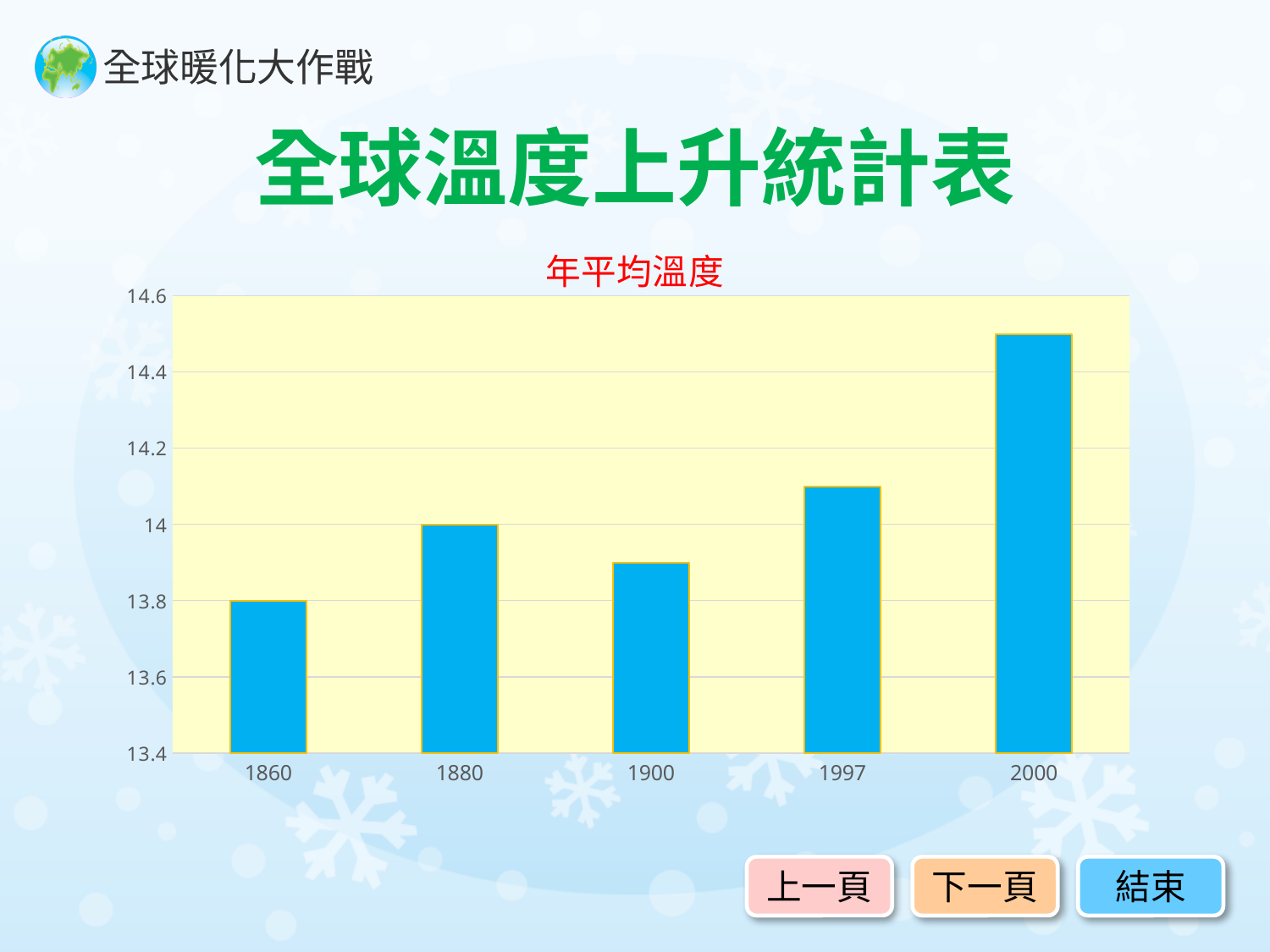
What is the value for 1880 in the chart? 14 Which is larger, the value for 1880 or the value for 1900? 1880 How many years are shown on the x axis of the chart? 5 Which year has the lowest average temperature in the chart? 1860 What is the value for 1860 in the chart? 13.8 Which year has the highest average temperature in the chart? 2000 Is the value for 2000 greater or less than 14.4? greater What is the title of the chart? 年平均溫度 Is the value for 1997 greater or less than 14? greater What kind of chart is shown on the slide? bar chart Is the value for 1900 greater or less than 14? less What colour are the bars in the chart? blue